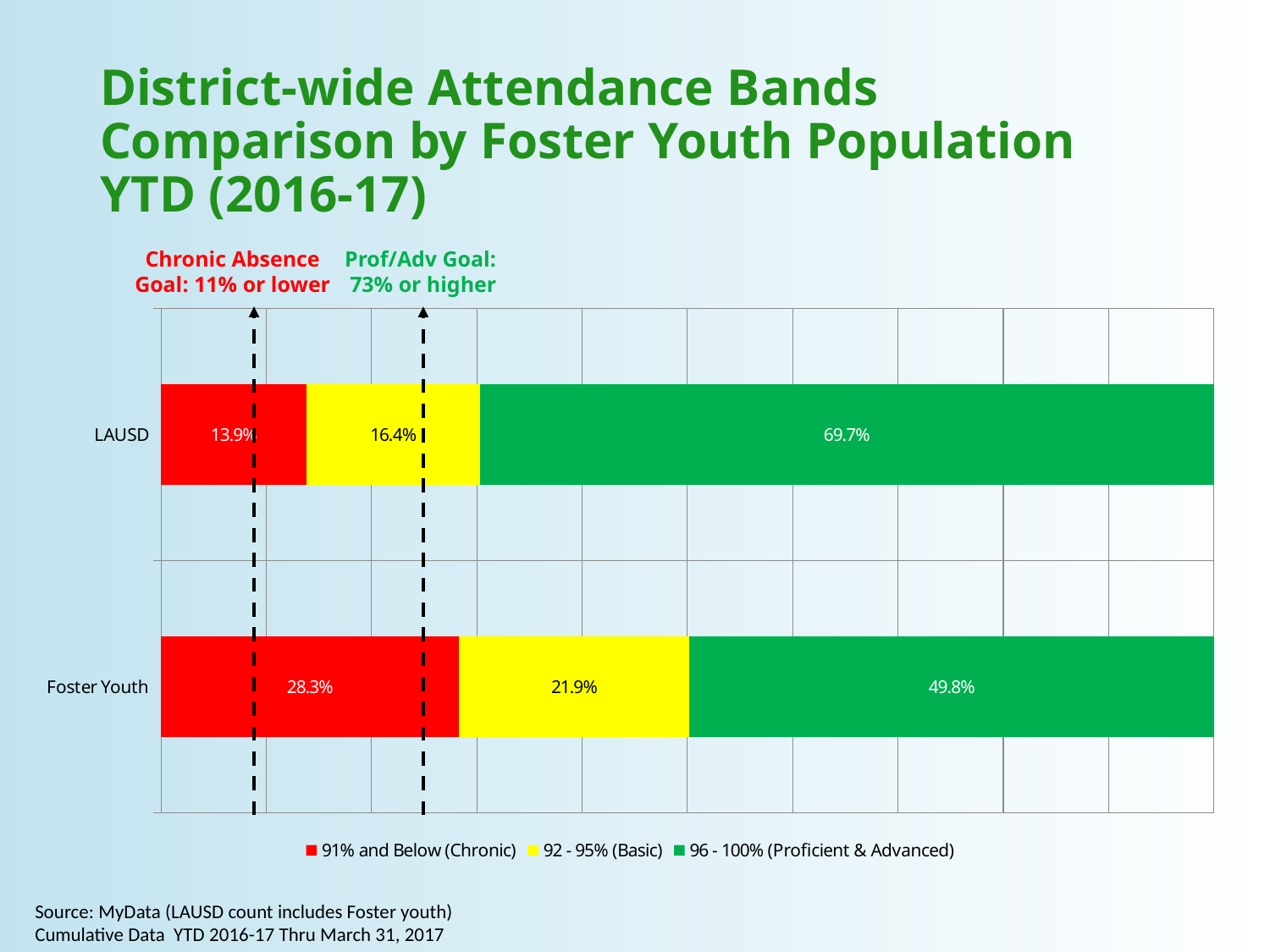
What is the difference between the 91% and Below (Chronic) values for Foster Youth and LAUSD? 14.4% What is the value of the 96 - 100% (Proficient & Advanced) segment for Foster Youth? 49.8% What is the value of the 92 - 95% (Basic) segment for Foster Youth? 21.9% How many series does the legend list? 3 Which category has the lower 96 - 100% (Proficient & Advanced) value? Foster Youth What is the difference between the 96 - 100% (Proficient & Advanced) values for LAUSD and Foster Youth? 19.9% How many categories are shown on the chart? 2 Which category has the higher 91% and Below (Chronic) value, LAUSD or Foster Youth? Foster Youth What is the value of the 96 - 100% (Proficient & Advanced) segment for LAUSD? 69.7% What colour represents the 92 - 95% (Basic) series? Yellow What kind of chart is shown on the slide? Stacked bar chart What is the value of the 91% and Below (Chronic) segment for LAUSD? 13.9%